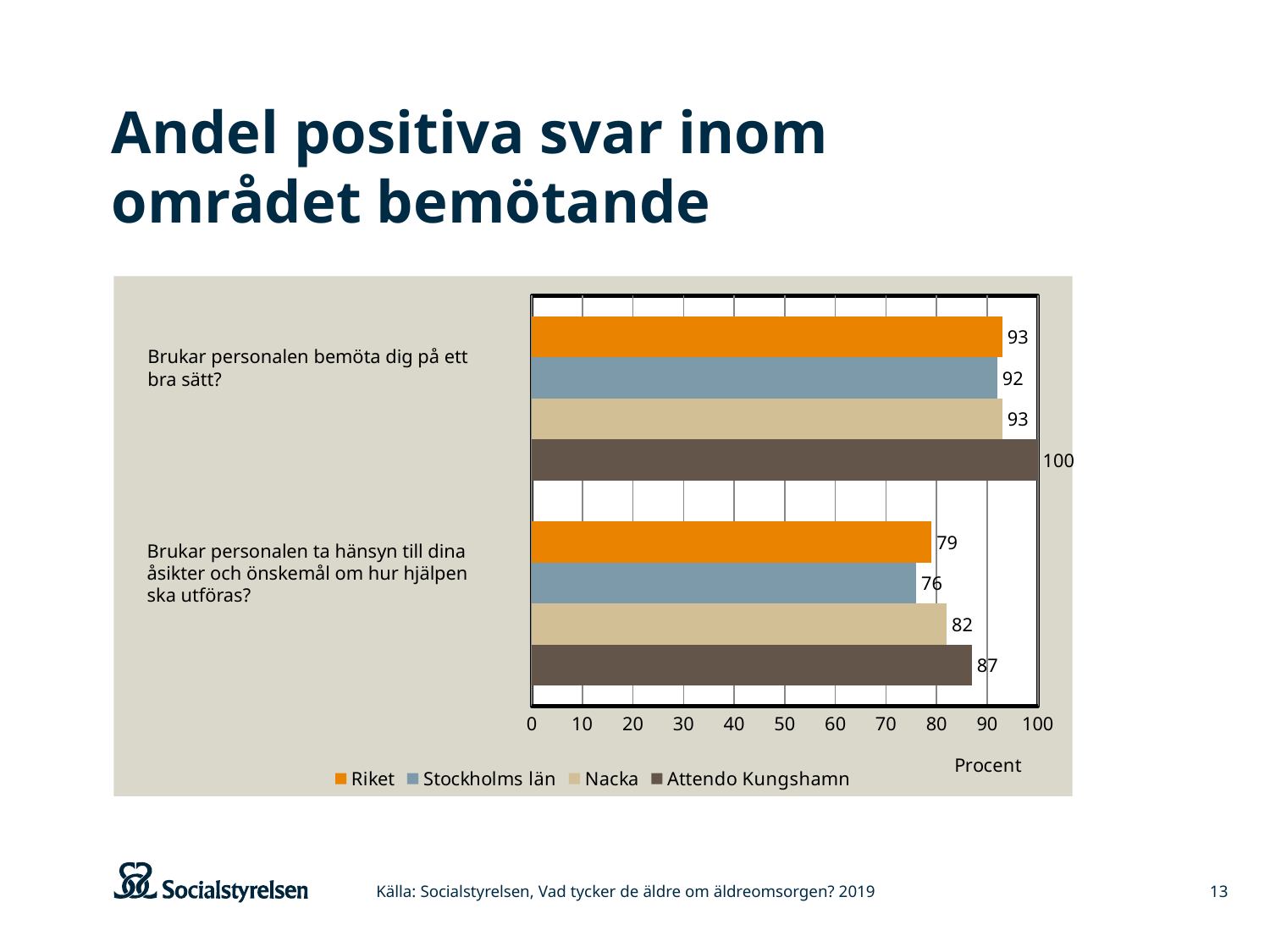
What is the value for Nacka on the question "Brukar personalen bemöta dig på ett bra sätt?"? 93 What is the difference between Attendo Kungshamn and Riket on the question "Brukar personalen bemöta dig på ett bra sätt?"? 7 What is the label of the horizontal axis? Procent Which series has the lowest value on the question "Brukar personalen ta hänsyn till dina åsikter och önskemål om hur hjälpen ska utföras?"? Stockholms län What kind of chart is shown on the slide? Bar chart Which is larger for Attendo Kungshamn: the value for "Brukar personalen bemöta dig på ett bra sätt?" or for "Brukar personalen ta hänsyn till dina åsikter och önskemål om hur hjälpen ska utföras?"? Brukar personalen bemöta dig på ett bra sätt? What is the value for Attendo Kungshamn on the question "Brukar personalen bemöta dig på ett bra sätt?"? 100 What is the value for Stockholms län on the question "Brukar personalen ta hänsyn till dina åsikter och önskemål om hur hjälpen ska utföras?"? 76 What is the difference between Nacka and Stockholms län on the question "Brukar personalen ta hänsyn till dina åsikter och önskemål om hur hjälpen ska utföras?"? 6 What is the value for Riket on the question "Brukar personalen ta hänsyn till dina åsikter och önskemål om hur hjälpen ska utföras?"? 79 How many series does the legend list? 4 Which series has the highest value on the question "Brukar personalen ta hänsyn till dina åsikter och önskemål om hur hjälpen ska utföras?"? Attendo Kungshamn